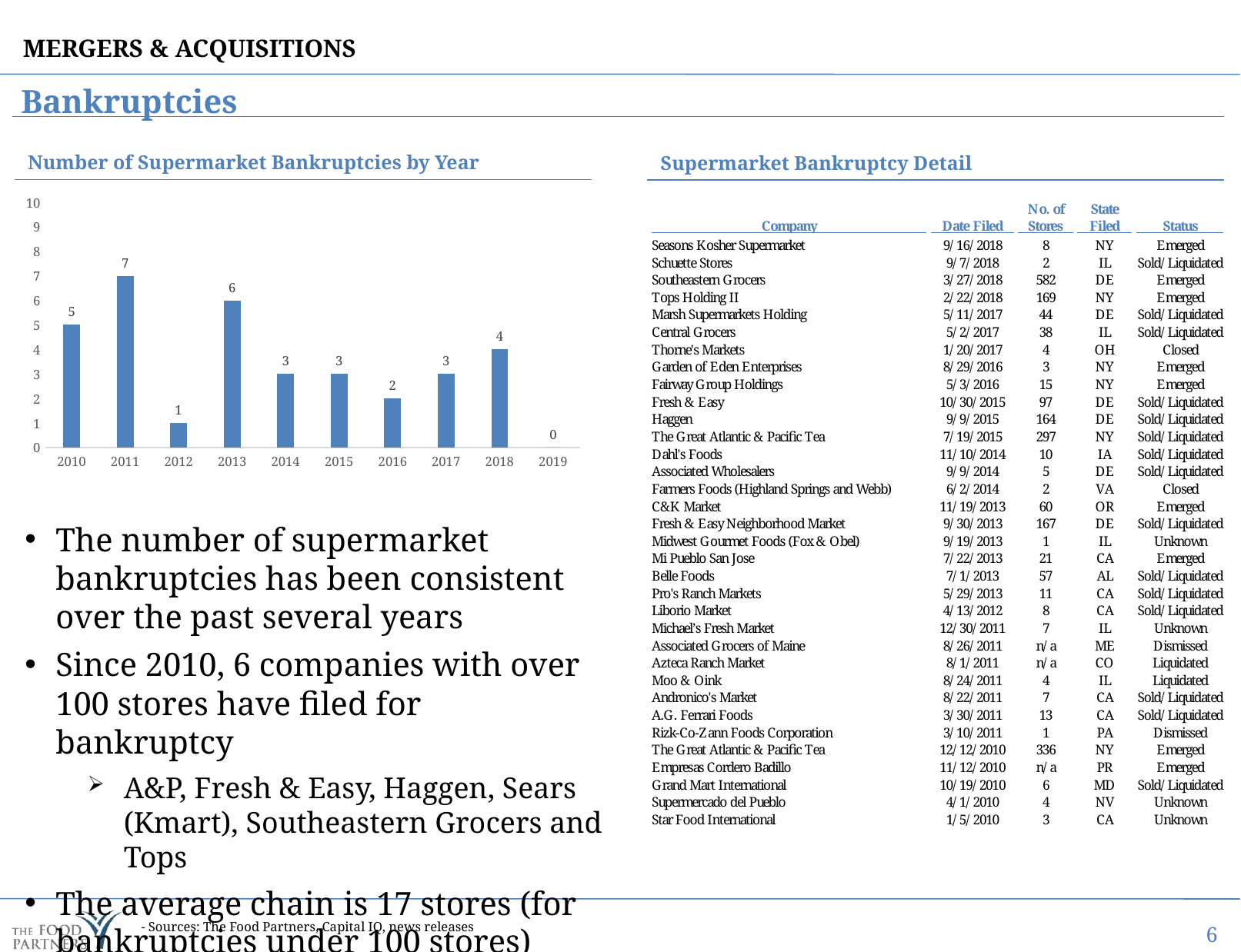
What is the difference between the number of bankruptcies in 2013 and in 2012? 5 What is the number of supermarket bankruptcies shown for 2016? 2 What is the maximum value shown on the chart's y axis? 10 Which year has the highest number of supermarket bankruptcies in the chart? 2011 Which year has the lowest number of supermarket bankruptcies in the chart? 2019 What is the number of supermarket bankruptcies shown for 2018? 4 What kind of chart is used to show the number of supermarket bankruptcies by year? bar chart How many years are shown on the x axis of the chart? 10 Did the number of supermarket bankruptcies rise or fall from 2011 to 2012? fall What is the title of the chart on the slide? Number of Supermarket Bankruptcies by Year What is the number of supermarket bankruptcies shown for 2011? 7 Which year had more supermarket bankruptcies, 2010 or 2018? 2010